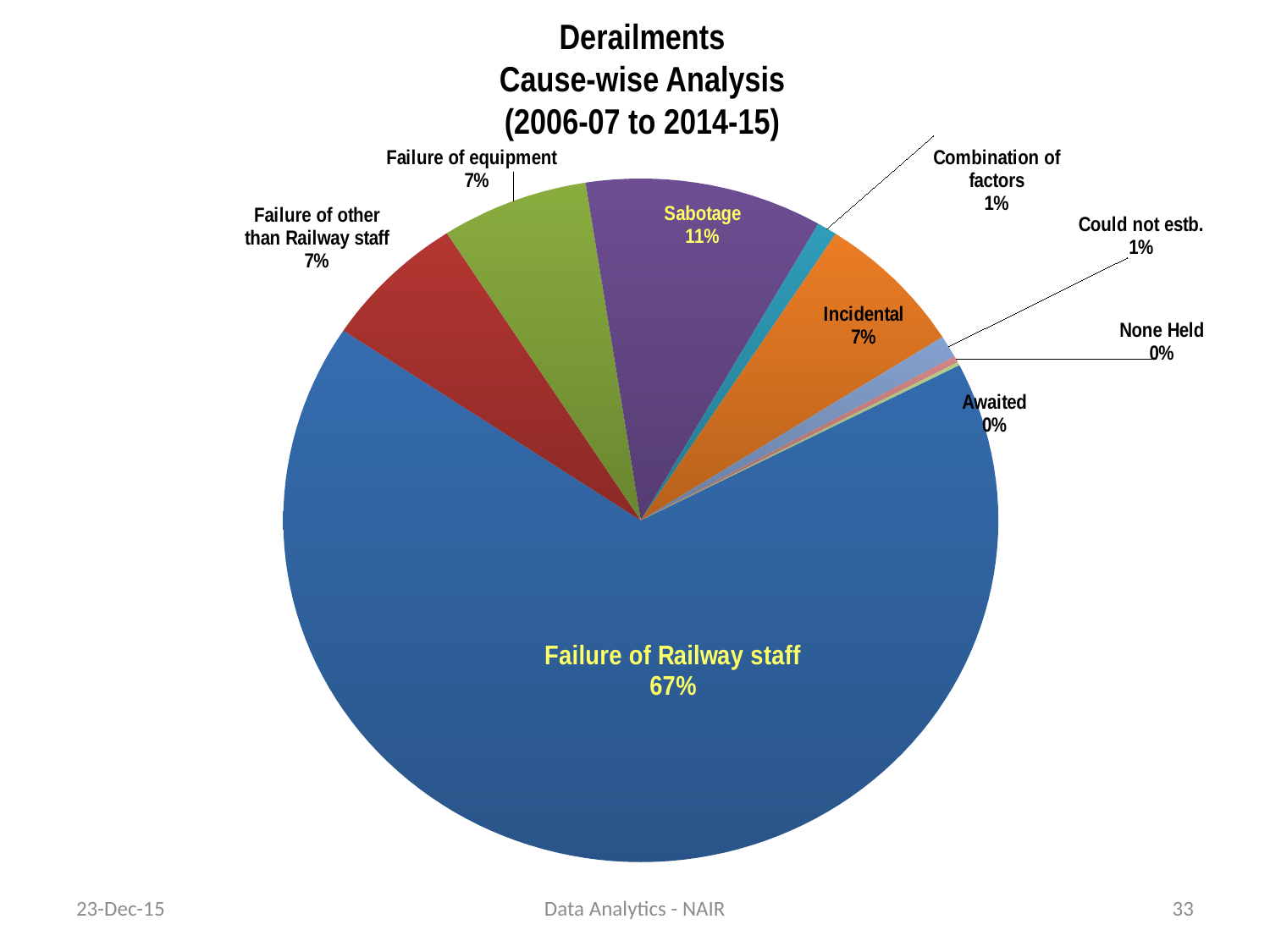
What share of derailments is attributed to Failure of Railway staff? 67% What period does the chart title say the analysis covers? 2006-07 to 2014-15 What percentage is shown for Could not estb.? 1% What kind of chart is shown on the slide? Pie chart Which cause accounts for the largest share of derailments? Failure of Railway staff What percentage is shown for Incidental? 7% What percentage is shown for Combination of factors? 1% Which is larger, the share for Sabotage or the share for Incidental? Sabotage What percentage is shown for Failure of equipment? 7% How many causes (slices) are shown in the pie chart? 9 What percentage of derailments is attributed to Sabotage? 11% What is the difference in percentage points between Failure of Railway staff and Sabotage? 56